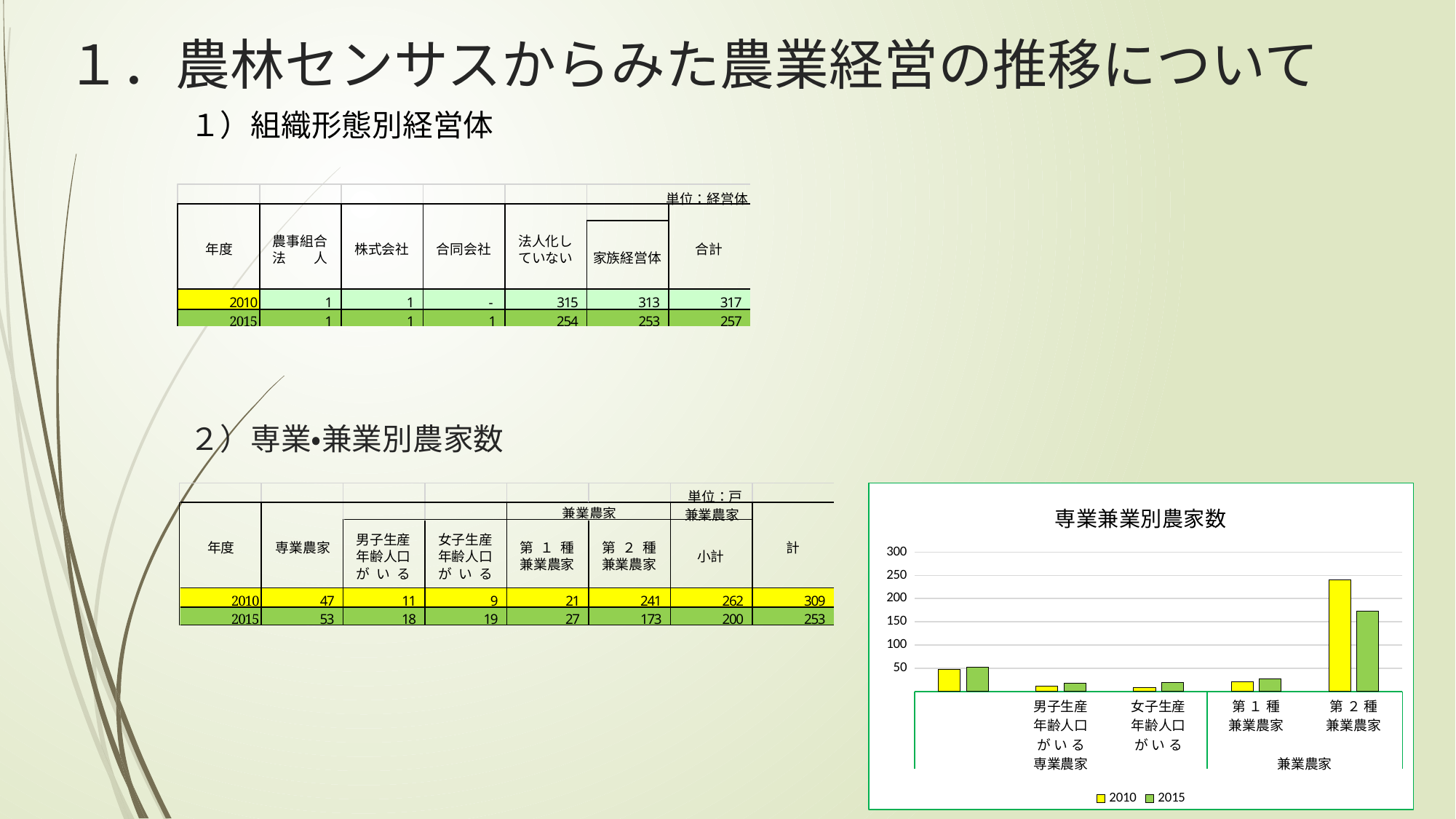
Is the 2015 value for 第２種兼業農家 greater or less than 150? greater Is the 2010 value for 第１種兼業農家 greater or less than 50? less How many series does the chart's legend list? 2 Which category has the highest 2010 value in the chart? 第２種兼業農家 Is the 2015 value for 第２種兼業農家 greater or less than 200? less What kind of chart is shown on the slide? bar chart Which category has the highest 2015 value in the chart? 第２種兼業農家 For 第２種兼業農家, which is larger, the 2010 value or the 2015 value? 2010 Which series is drawn in yellow in the chart? 2010 How many categories of bars are plotted in the chart? 5 What is the title of the chart on the slide? 専業兼業別農家数